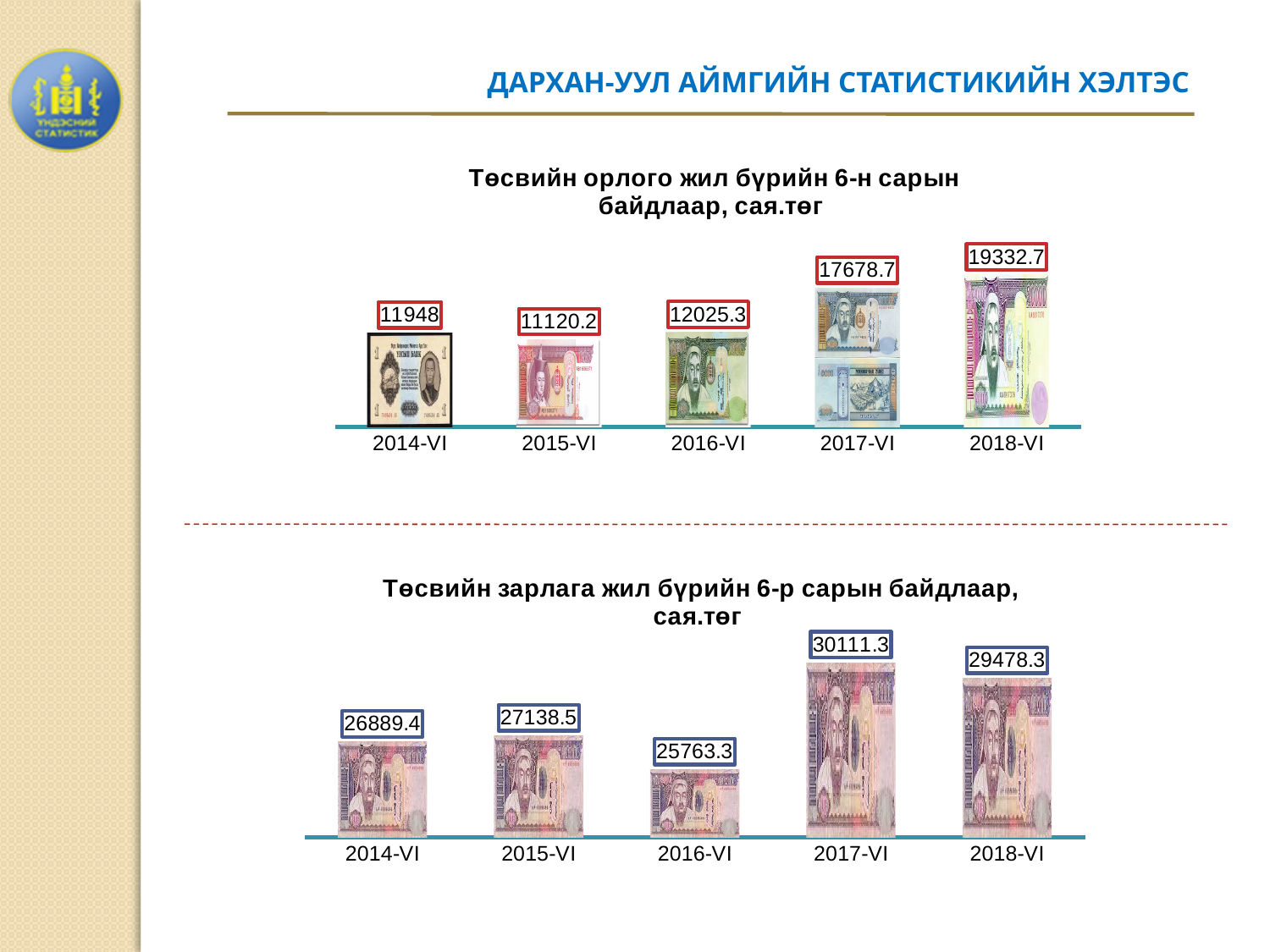
In the bottom chart (Төсвийн зарлага), what is the value for 2016-VI? 25763.3 In the top chart (Төсвийн орлого), which period has the highest value? 2018-VI In the top chart (Төсвийн орлого), which period has the lowest value? 2015-VI What kind of chart is the bottom chart (Төсвийн зарлага)? Bar chart In the bottom chart (Төсвийн зарлага), which period has the lowest value? 2016-VI In the bottom chart (Төсвийн зарлага), what is the value for 2017-VI? 30111.3 In the top chart (Төсвийн орлого), what is the difference between the 2018-VI and 2017-VI values? 1654 In the top chart (Төсвийн орлого), what is the value for 2015-VI? 11120.2 In the bottom chart (Төсвийн зарлага), which is larger, the value for 2017-VI or 2018-VI? 2017-VI In the top chart (Төсвийн орлого), what is the value for 2018-VI? 19332.7 In the bottom chart (Төсвийн зарлага), what is the difference between the 2015-VI and 2014-VI values? 249.1 In the top chart (Төсвийн орлого), how many periods are shown on the x axis? 5